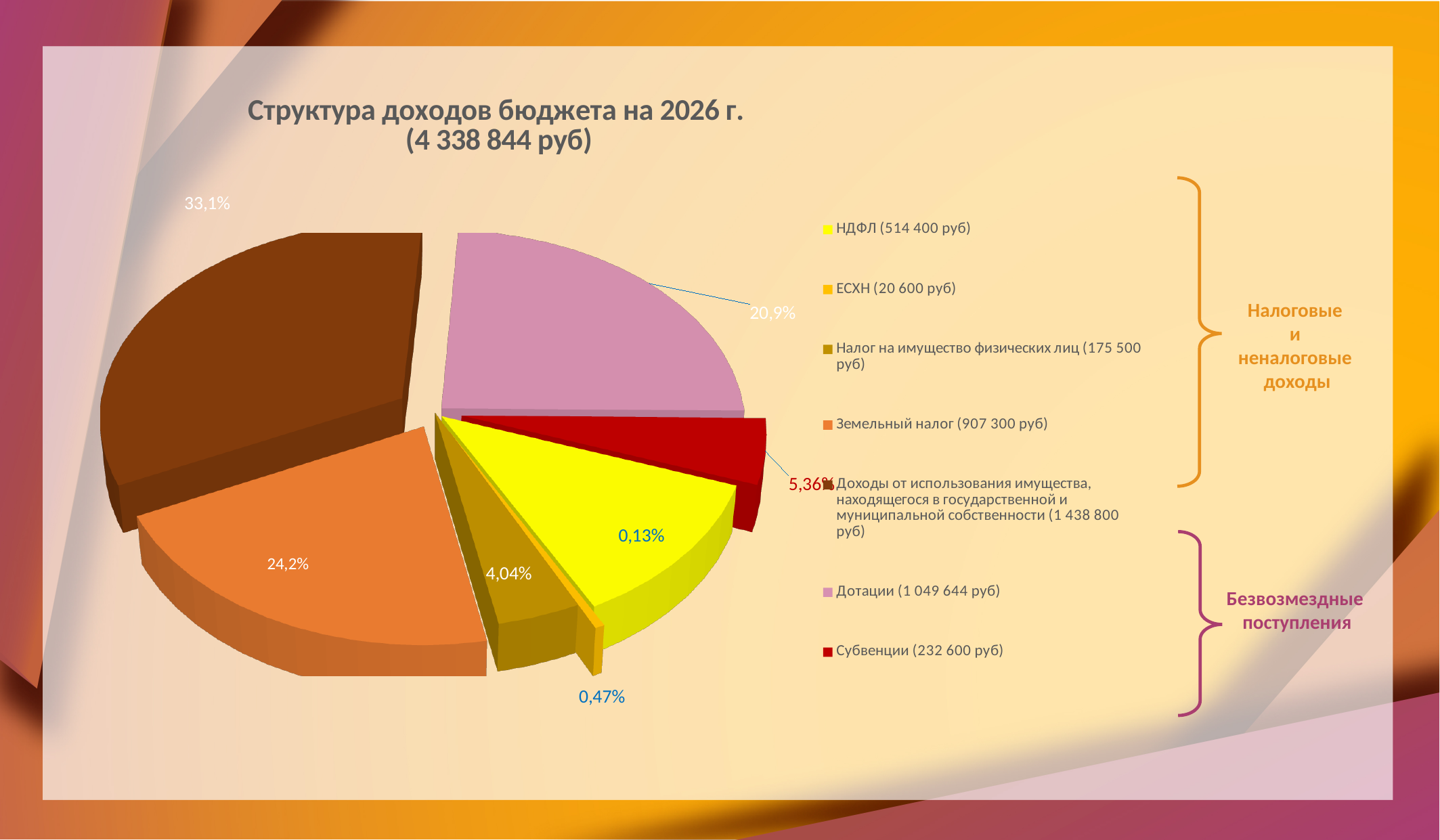
Which category has the largest amount according to the legend? Доходы от использования имущества, находящегося в государственной и муниципальной собственности (1 438 800 руб) What percentage label is shown on the largest (brown) slice of the pie? 33,1% What amount is shown in the legend for НДФЛ? 514 400 руб Which category has the smallest amount according to the legend? ЕСХН (20 600 руб) How many categories does the legend of the pie chart list? 7 What kind of chart is shown on the slide? Pie chart What is the difference between the legend amounts for НДФЛ and Субвенции? 281 800 руб What amount is shown in the legend for Субвенции? 232 600 руб What amount is shown in the legend for Земельный налог? 907 300 руб What is the title of the chart? Структура доходов бюджета на 2026 г. (4 338 844 руб) What amount is shown in the legend for Дотации? 1 049 644 руб Which is larger according to the legend: Земельный налог or Дотации? Дотации